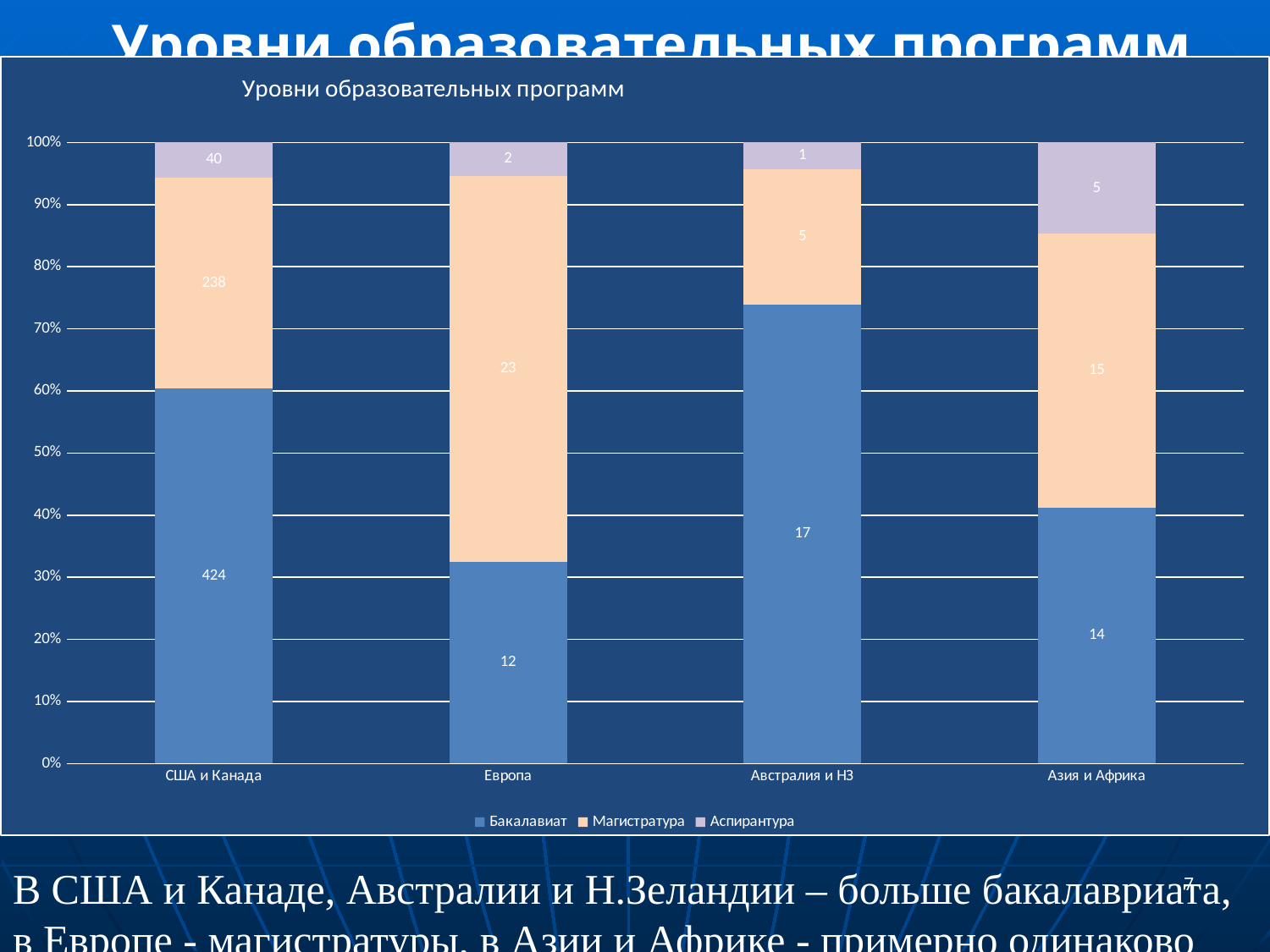
What is the value for Магистратура in Европа? 23 How many series does the legend list? 3 Which category has the lowest value for Аспирантура? Австралия и НЗ What is the total of the stacked bar for Европа? 37 What is the value for Бакалавиат in США и Канада? 424 Which category has the highest value for Бакалавиат? США и Канада Which is larger in Азия и Африка: Бакалавиат or Магистратура? Магистратура What is the value for Аспирантура in Азия и Африка? 5 How many categories are shown on the x axis? 4 What is the difference between Магистратура and Бакалавиат in США и Канада? 186 What is the value for Магистратура in Австралия и НЗ? 5 What kind of chart is this? Stacked bar chart